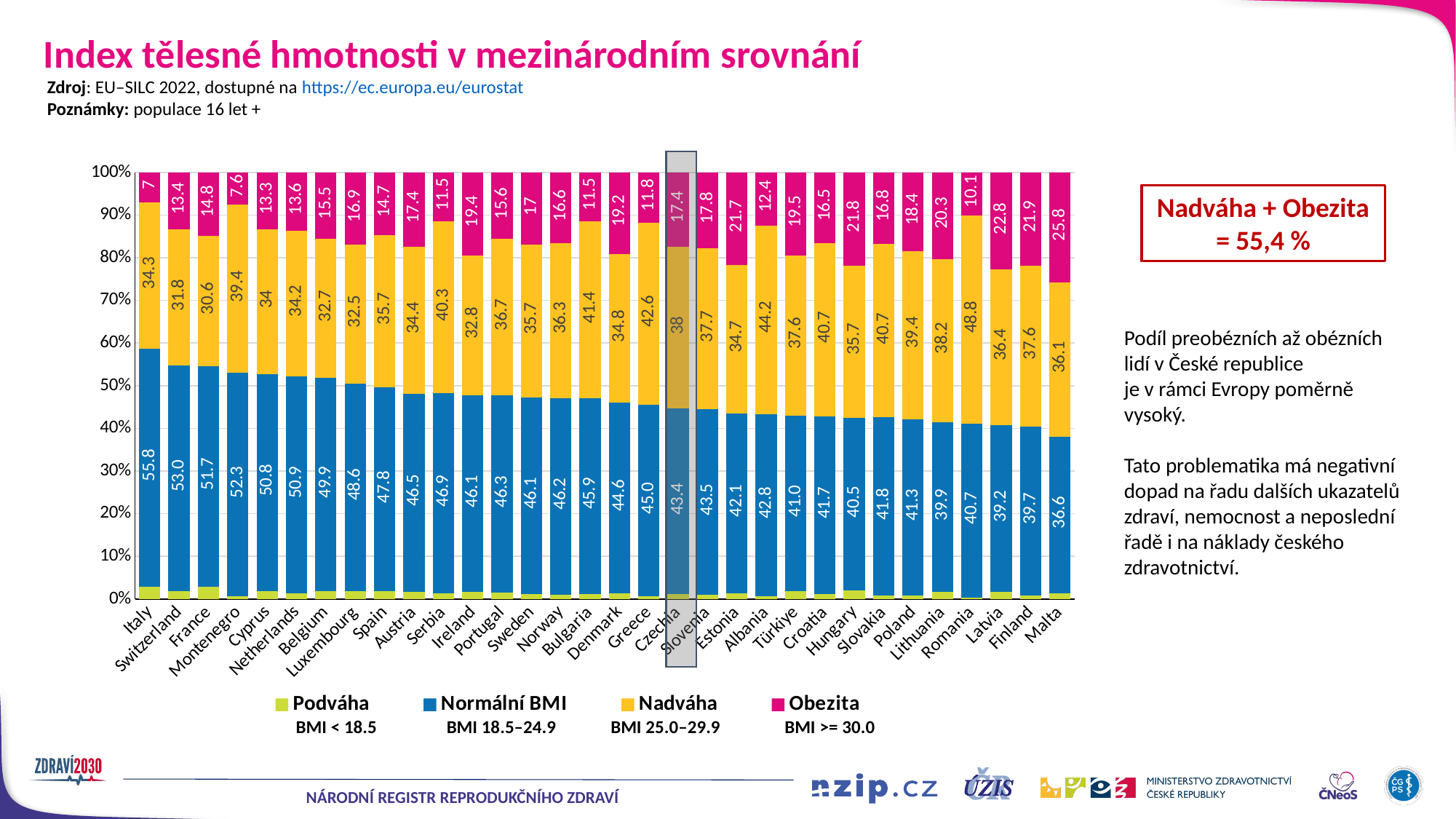
Which country has the highest Normální BMI value? Italy What is the difference between the Obezita value for Malta and the Obezita value for Italy? 18.8 What is the Normální BMI value for Czechia? 43.4 What kind of chart is shown on the slide? stacked bar chart What is the combined Nadváha and Obezita value for Czechia? 55.4 Do the Normální BMI values rise or fall from left to right along the x axis? fall What is the Obezita value for Czechia? 17.4 Which country has the highest Obezita value? Malta How many series does the legend list? 4 How many countries are shown on the x axis of the chart? 32 Which country has the lowest Obezita value? Italy What is the Nadváha value for Romania? 48.8